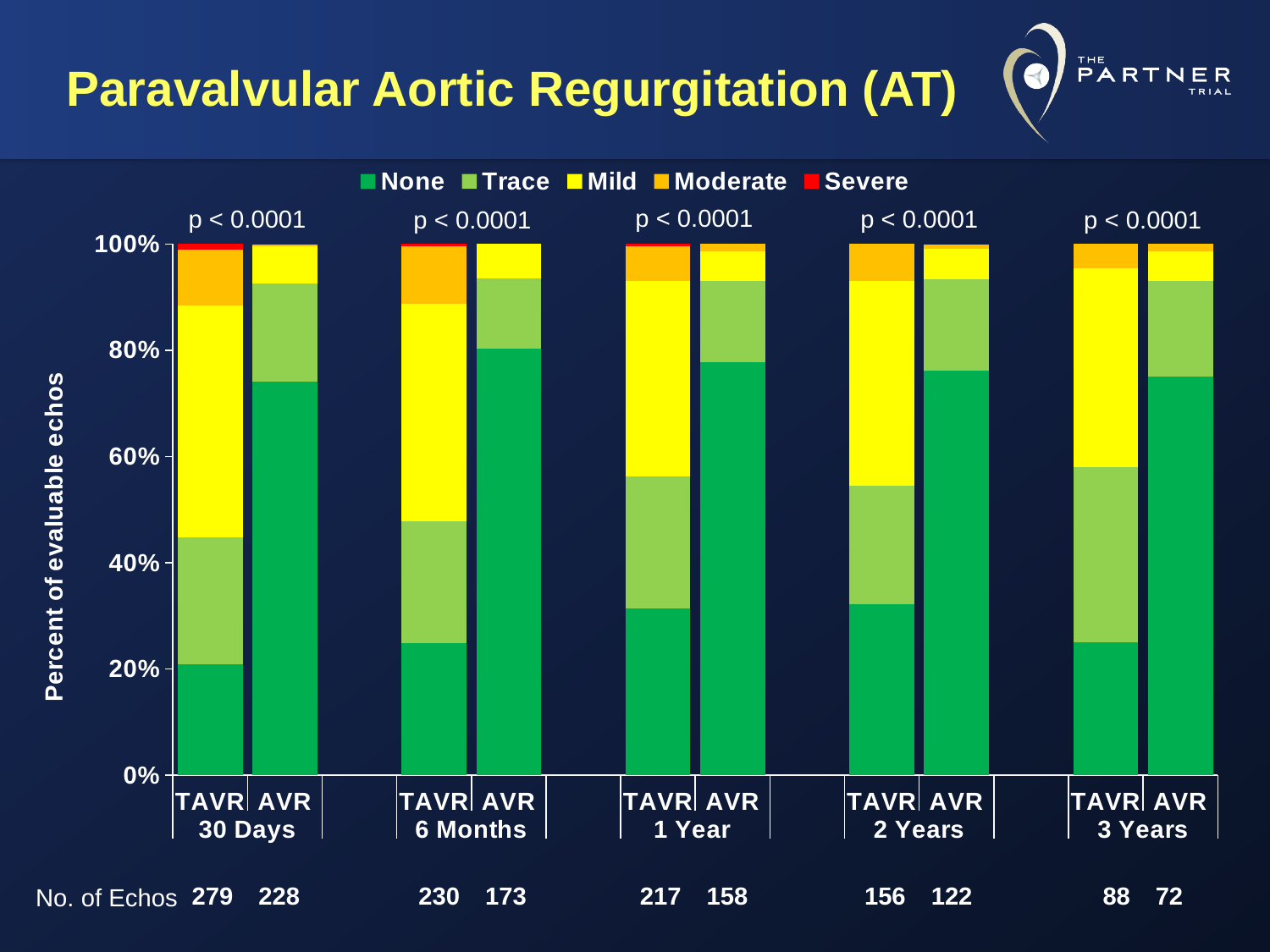
At 3 Years, which group has the larger 'Mild' segment, TAVR or AVR? TAVR Is the 'None' segment for AVR at 30 Days greater or less than 60%? greater How many series does the legend list? 5 What kind of chart is shown on the slide? Stacked bar chart What is the total height of each stacked bar? 100% What is the number of echos for TAVR at 30 Days? 279 Is the 'None' segment for AVR at 6 Months greater or less than 60%? greater What is the number of echos for AVR at 3 Years? 72 What is the label of the y axis? Percent of evaluable echos How many bars are plotted in the chart? 10 At 1 Year, which group has the larger 'None' segment, TAVR or AVR? AVR Is the 'None' segment for TAVR at 30 Days greater or less than 40%? less